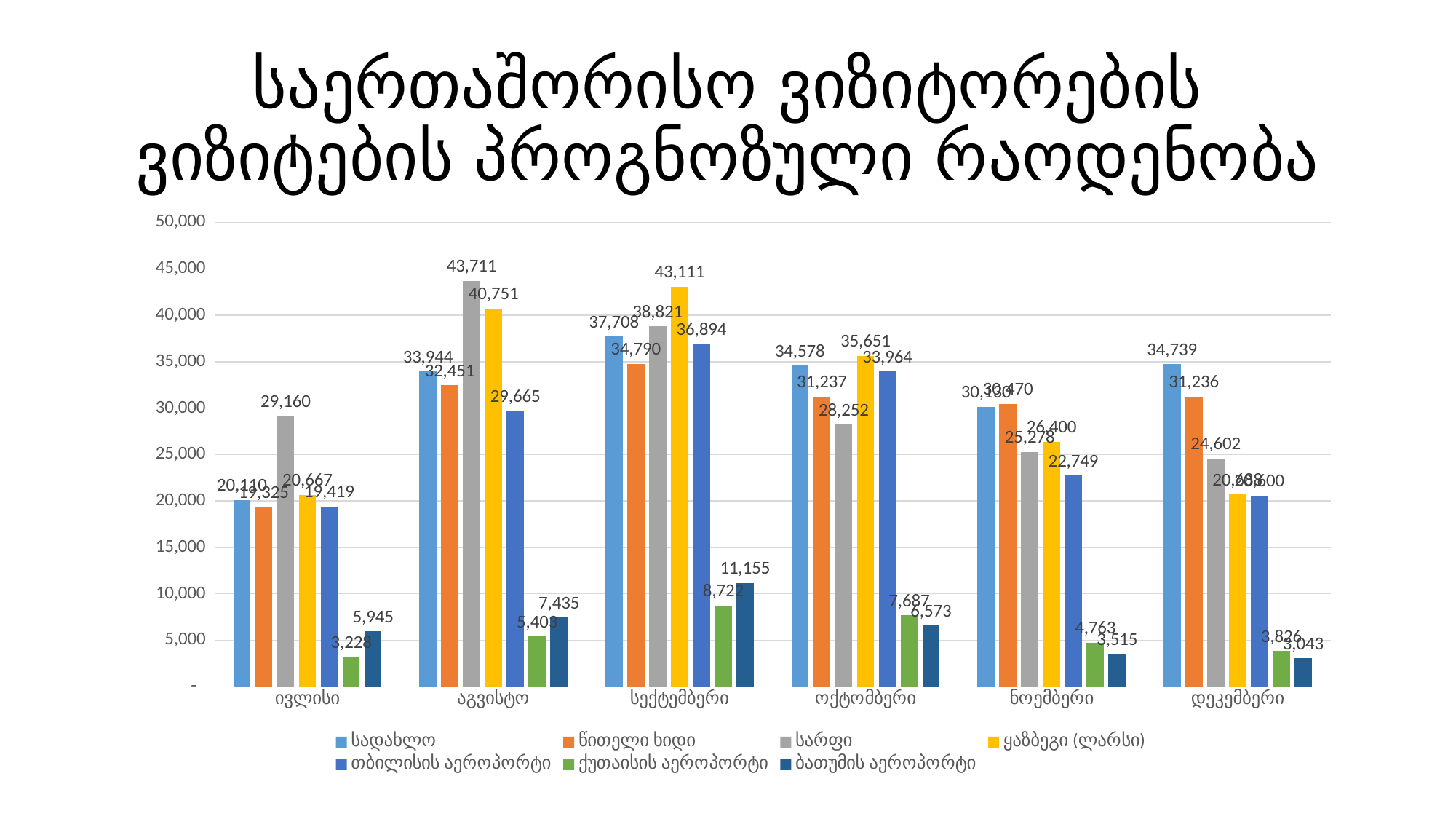
Which series has the highest value in ოქტომბერი? ყაზბეგი (ლარსი) Which is larger in აგვისტო: სარფი or ყაზბეგი (ლარსი)? სარფი Is the value for თბილისის აეროპორტი in ნოემბერი greater or less than 25,000? less What is the value for სარფი in აგვისტო? 43,711 What is the value for ქუთაისის აეროპორტი in ივლისი? 3,228 What is the value for ყაზბეგი (ლარსი) in სექტემბერი? 43,111 Which series has the lowest value in დეკემბერი? ბათუმის აეროპორტი What is the value for ბათუმის აეროპორტი in სექტემბერი? 11,155 How many months are shown on the x axis? 6 How many series does the legend list? 7 What kind of chart is shown on the slide? bar chart What is the difference between სარფი and სადახლო in ივლისი? 9,050